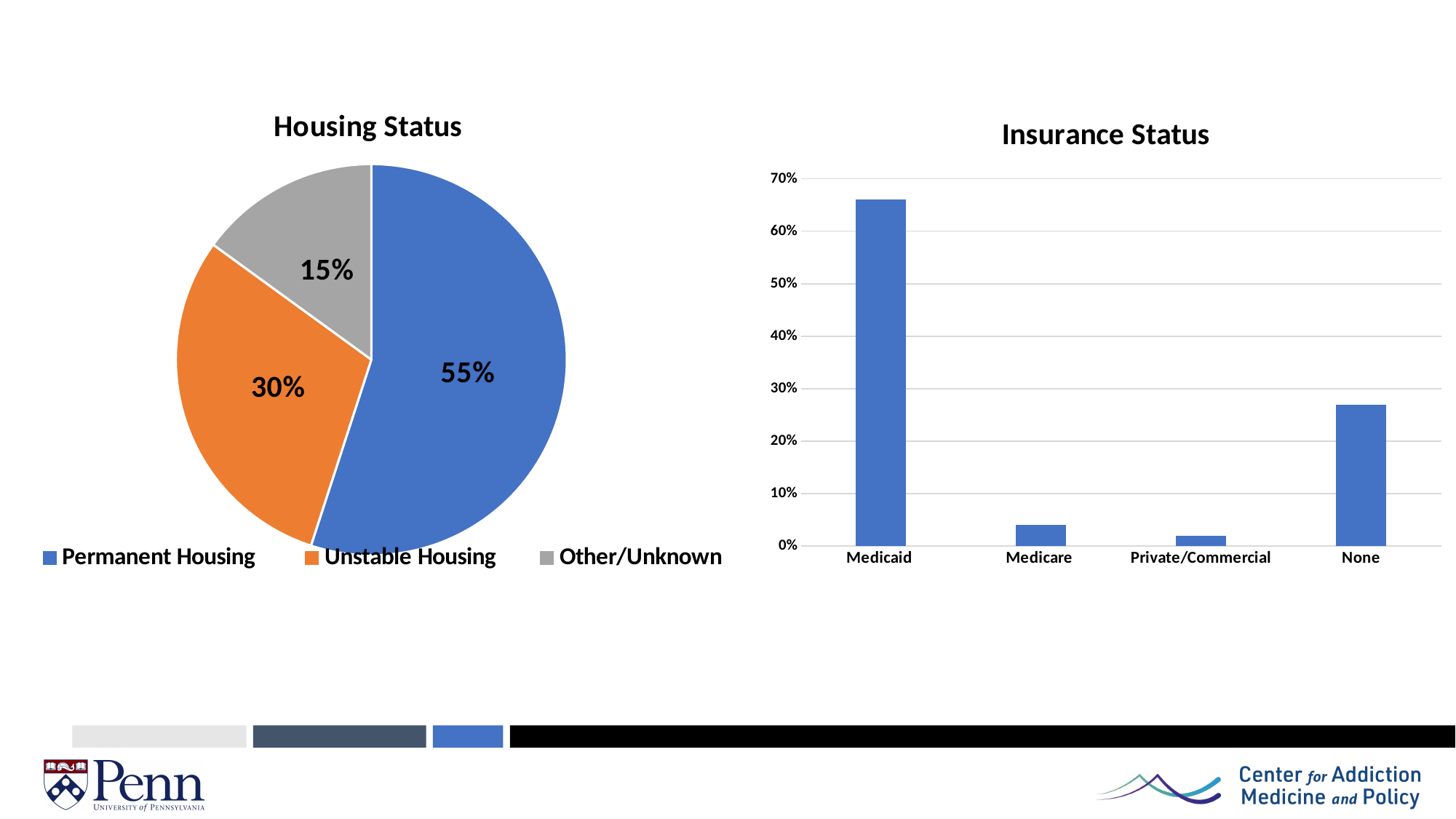
What kind of chart is the Insurance Status chart? Bar chart In the Housing Status chart, what percentage is Unstable Housing? 30% What kind of chart is the Housing Status chart? Pie chart In the Insurance Status chart, is the value for None greater or less than 20%? greater In the Housing Status chart, what percentage is Other/Unknown? 15% In the Insurance Status chart, which category has the highest value? Medicaid In the Housing Status chart, what percentage is Permanent Housing? 55% In the Insurance Status chart, is the value for Medicaid greater or less than 60%? greater How many categories does the Housing Status chart's legend list? 3 In the Housing Status chart, which category has the largest share? Permanent Housing In the Housing Status chart, which category has the smallest share? Other/Unknown In the Housing Status chart, what is the difference between Permanent Housing and Unstable Housing? 25%